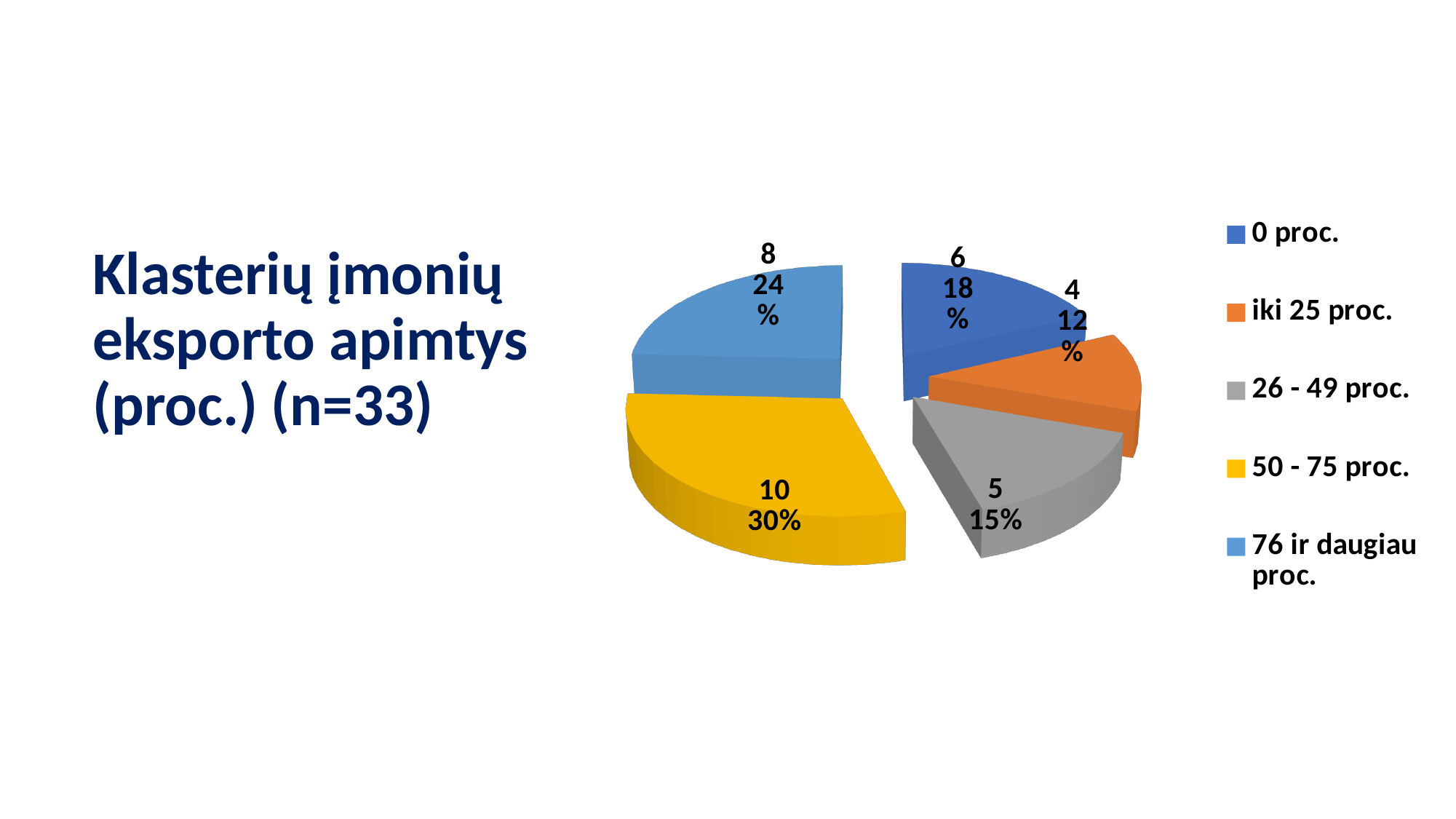
How many slices does the pie chart have? 5 What is the count shown for the 'iki 25 proc.' slice? 4 What is the difference in count between the '50 - 75 proc.' slice and the '26 - 49 proc.' slice? 5 How many entries does the legend list? 5 What percentage share is shown for the '76 ir daugiau proc.' slice? 24% Which category has the smallest slice of the pie? iki 25 proc. What kind of chart is shown on the slide? Pie chart Which slice is larger, '0 proc.' or '26 - 49 proc.'? 0 proc. What is the count shown for the '50 - 75 proc.' slice? 10 What is the title of the chart on the slide? Klasterių įmonių eksporto apimtys (proc.) (n=33) What percentage share is shown for the '0 proc.' slice? 18% Which category has the largest slice of the pie? 50 - 75 proc.